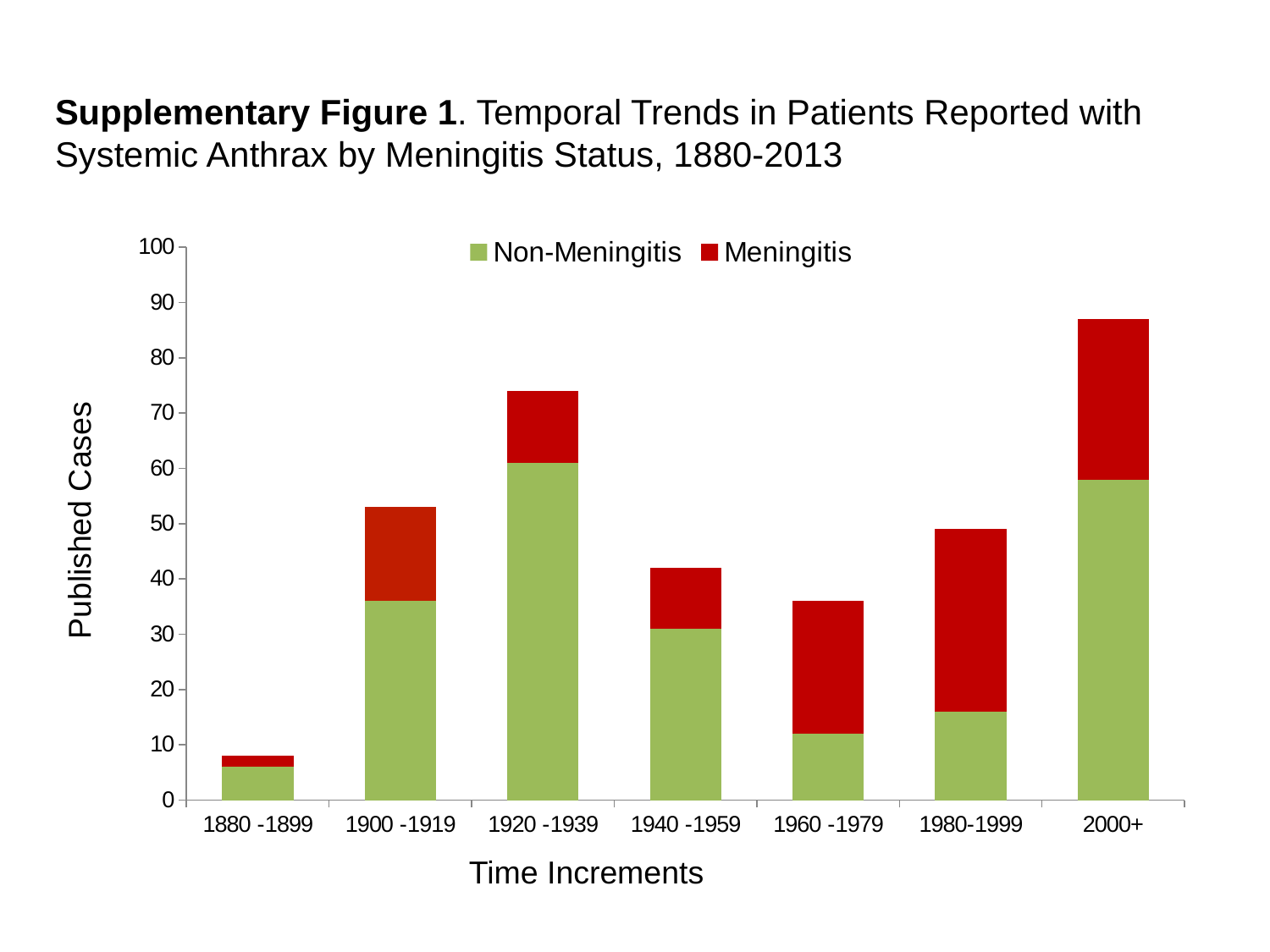
Is the total number of published cases for 1960 -1979 greater or less than 40? less How many time increments are shown on the x axis? 7 What kind of chart is shown on the slide? Stacked bar chart Which time increment has the smallest number of Meningitis cases? 1880 -1899 Is the total number of published cases for 2000+ greater or less than 80? greater Which has more Non-Meningitis cases, 1920 -1939 or 1980-1999? 1920 -1939 Which time increment has the highest total number of published cases? 2000+ Is the number of Non-Meningitis cases for 1900 -1919 greater or less than 40? less What is the label of the y axis? Published Cases Which time increment has the lowest total number of published cases? 1880 -1899 How many series does the legend list? 2 Which has a larger total of published cases, 1900 -1919 or 1940 -1959? 1900 -1919